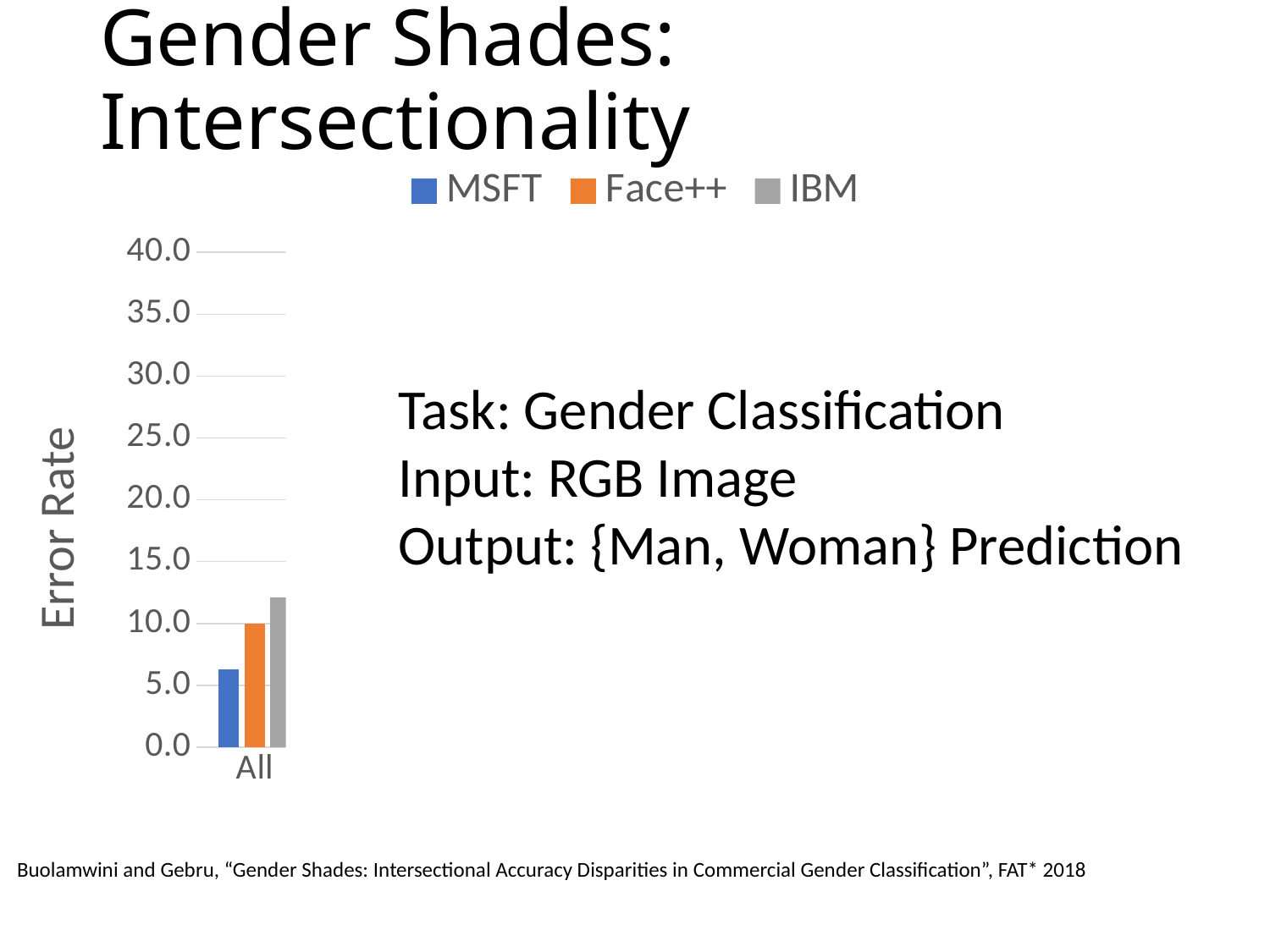
Is the error rate for IBM greater or less than 15.0? less Is the error rate for MSFT greater or less than 5.0? greater What kind of chart is shown on the slide? bar chart Which series is shown in orange in the chart legend? Face++ How many categories are shown on the x axis of the chart? 1 Which series has the highest error rate for the All category? IBM Is the error rate for MSFT greater or less than 10.0? less How many series does the chart legend list? 3 Is the error rate for Face++ larger or smaller than the error rate for MSFT? larger What is the label of the y axis of the chart? Error Rate Which series has the lowest error rate for the All category? MSFT